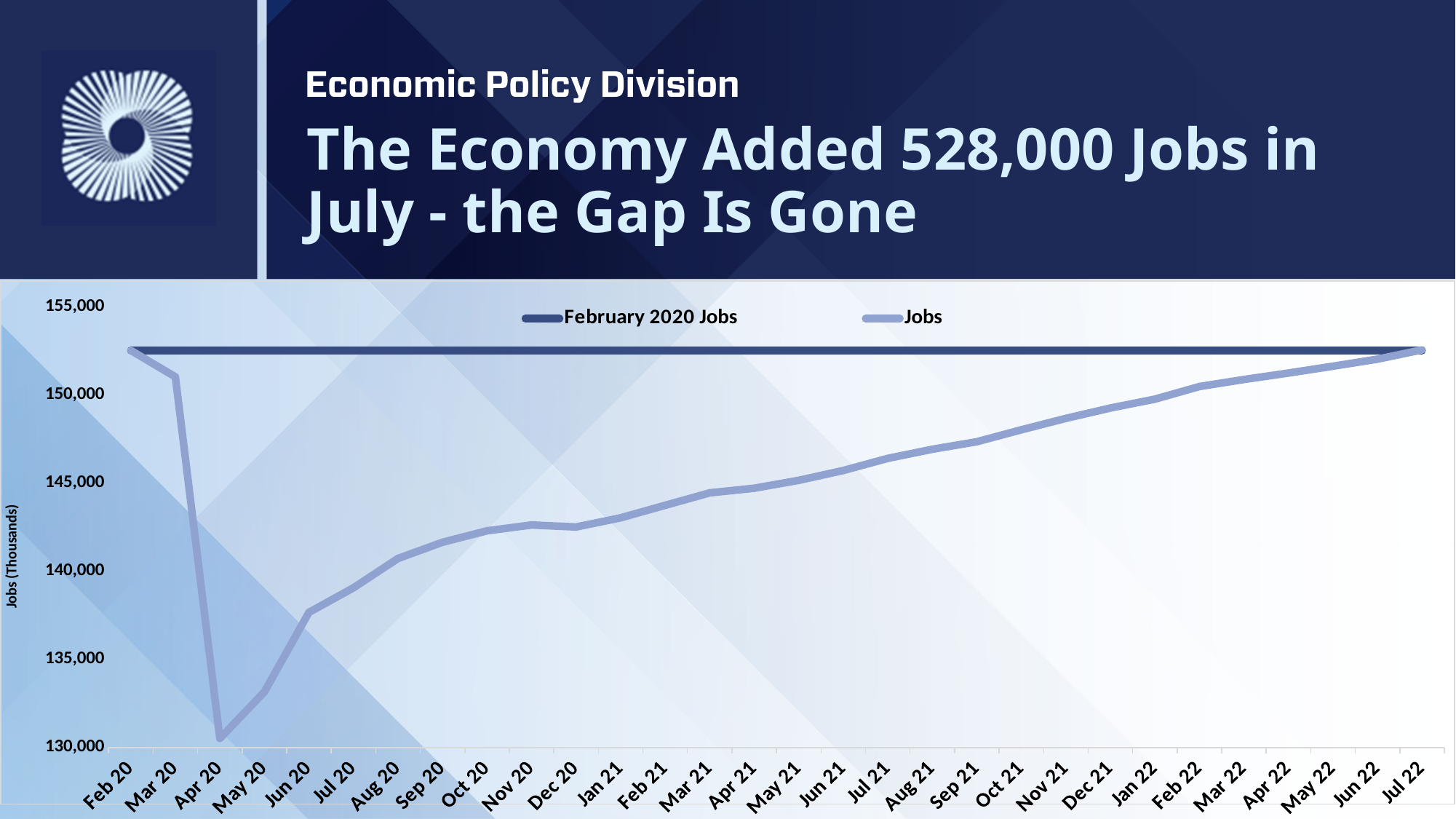
Is the value of the Jobs series for Apr 20 greater or less than 135,000? less What kind of chart is shown on the slide? line chart What are the two series named in the legend? February 2020 Jobs and Jobs How many months are plotted along the x axis? 30 Is the value of the Jobs series for Jul 22 greater or less than 150,000? greater Is the value of the Jobs series for Jun 20 greater or less than 140,000? less How many series does the legend list? 2 What is the label on the vertical axis? Jobs (Thousands) In which month does the Jobs series reach its lowest value? Apr 20 Does the Jobs series rise or fall from Apr 20 to Jul 22? rise In which month does the Jobs series reach its highest value? Jul 22